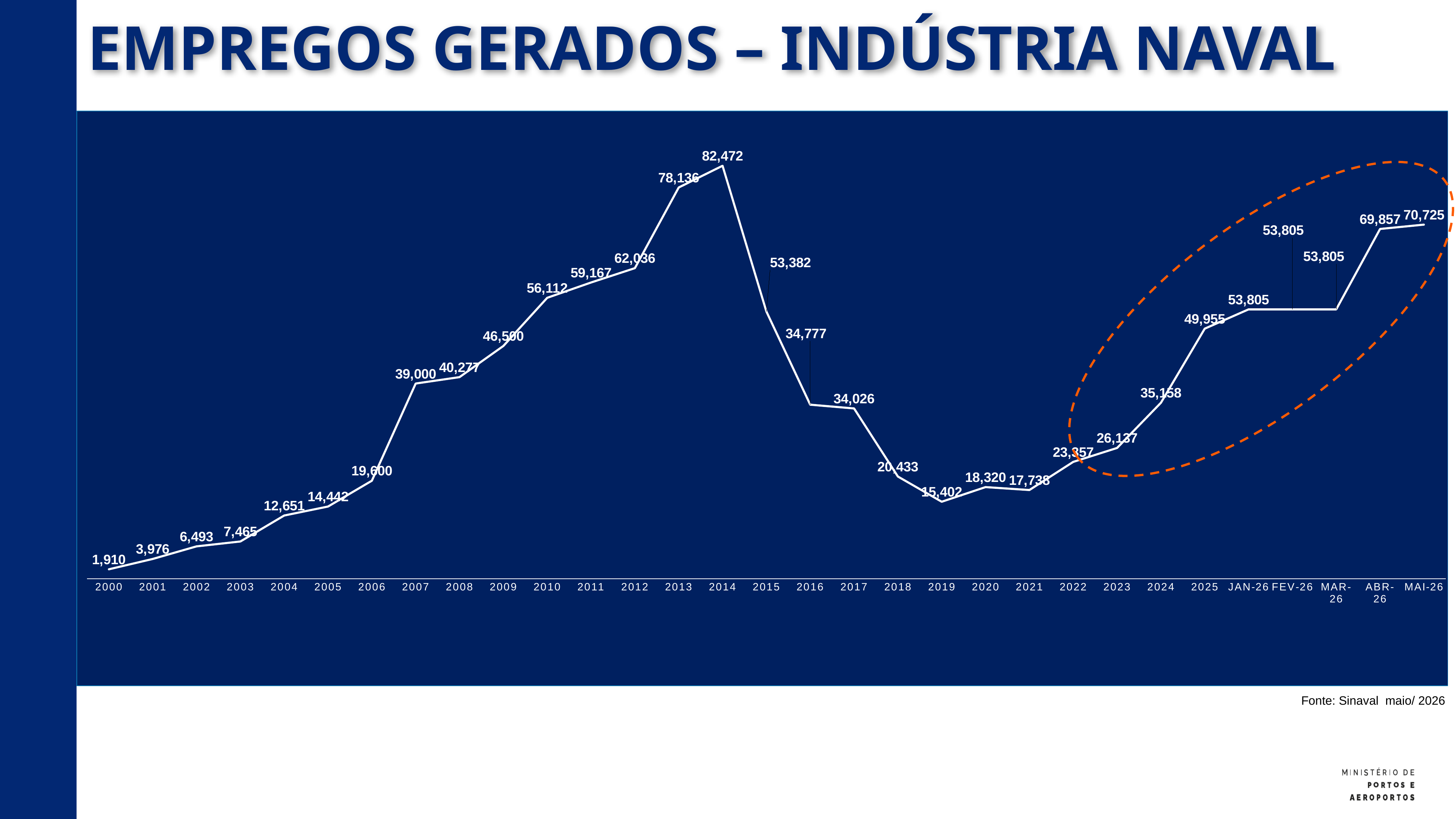
What is the value for 2007? 39,000 Which period has the lowest value? 2000 How many data points are plotted on the chart? 31 What is the value for MAI-26? 70,725 Which period has the highest value? 2014 What is the value for 2000? 1,910 What is the difference between the values for MAI-26 and ABR-26? 868 What is the difference between the values for 2014 and 2013? 4,336 Which is larger, the value for 2012 or the value for 2015? 2012 Do the values rise or fall from 2014 to 2019? Fall What type of chart is shown on the slide? Line chart What is the value for 2014? 82,472